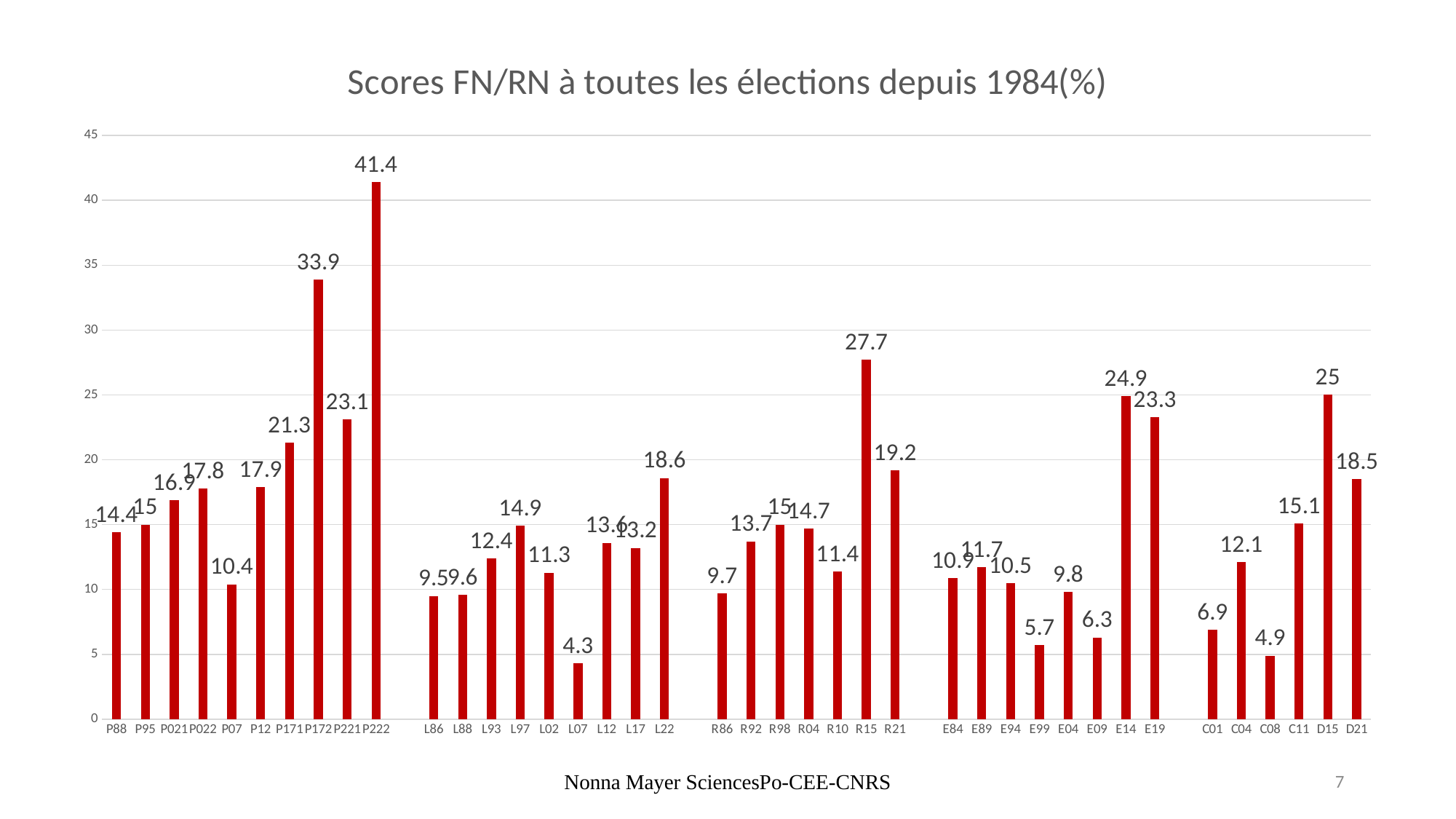
What is the value for L07? 4.3 What is the value for P222? 41.4 What is the title of the chart? Scores FN/RN à toutes les élections depuis 1984(%) Which category has the lowest value? L07 Is the value for C08 greater or less than 5? less Which is larger, the value for D15 or the value for E19? D15 Which category has the highest value? P222 What is the difference between the values for P222 and P172? 7.5 What is the value for R15? 27.7 What is the value for E14? 24.9 How many bars are plotted on the chart? 40 What kind of chart is shown on the slide? bar chart